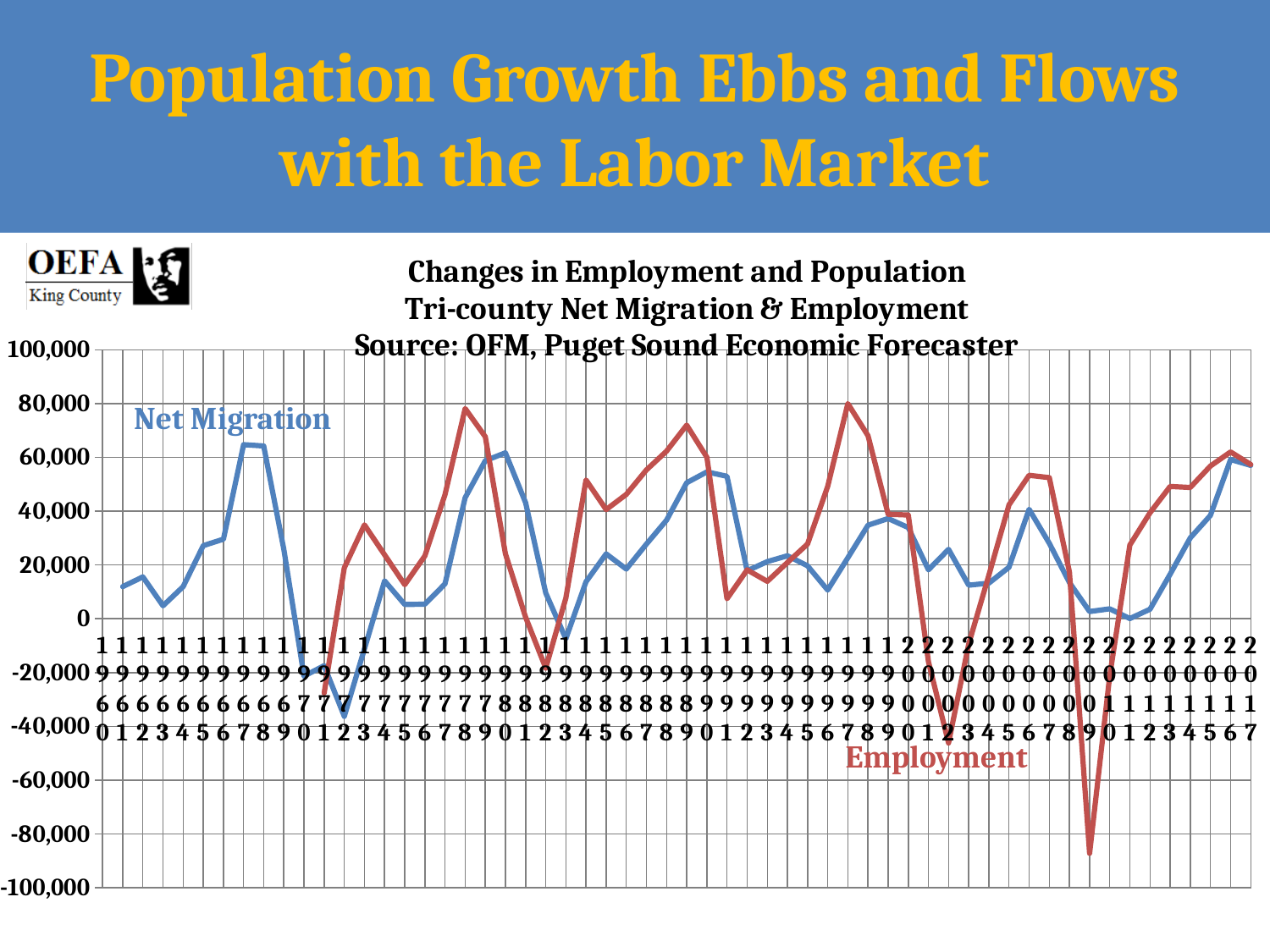
What are the names of the two series plotted on the chart? Net Migration and Employment Is the Employment value for 2009 greater or less than -60,000? less In which year does the Employment series reach its lowest value? 2009 How many data series are plotted on the chart? 2 Is the Employment value for 2000 greater or less than 60,000? less In which year does the Net Migration series reach its lowest value? 1972 Does the Net Migration series rise or fall from 2013 to 2016? Rise What kind of chart is shown on the slide? Line chart In 2000, which series has the higher value, Net Migration or Employment? Employment What colour is the Employment line? Red How many years are shown along the x axis of the chart? 58 Is the Net Migration value for 1972 greater or less than -20,000? less